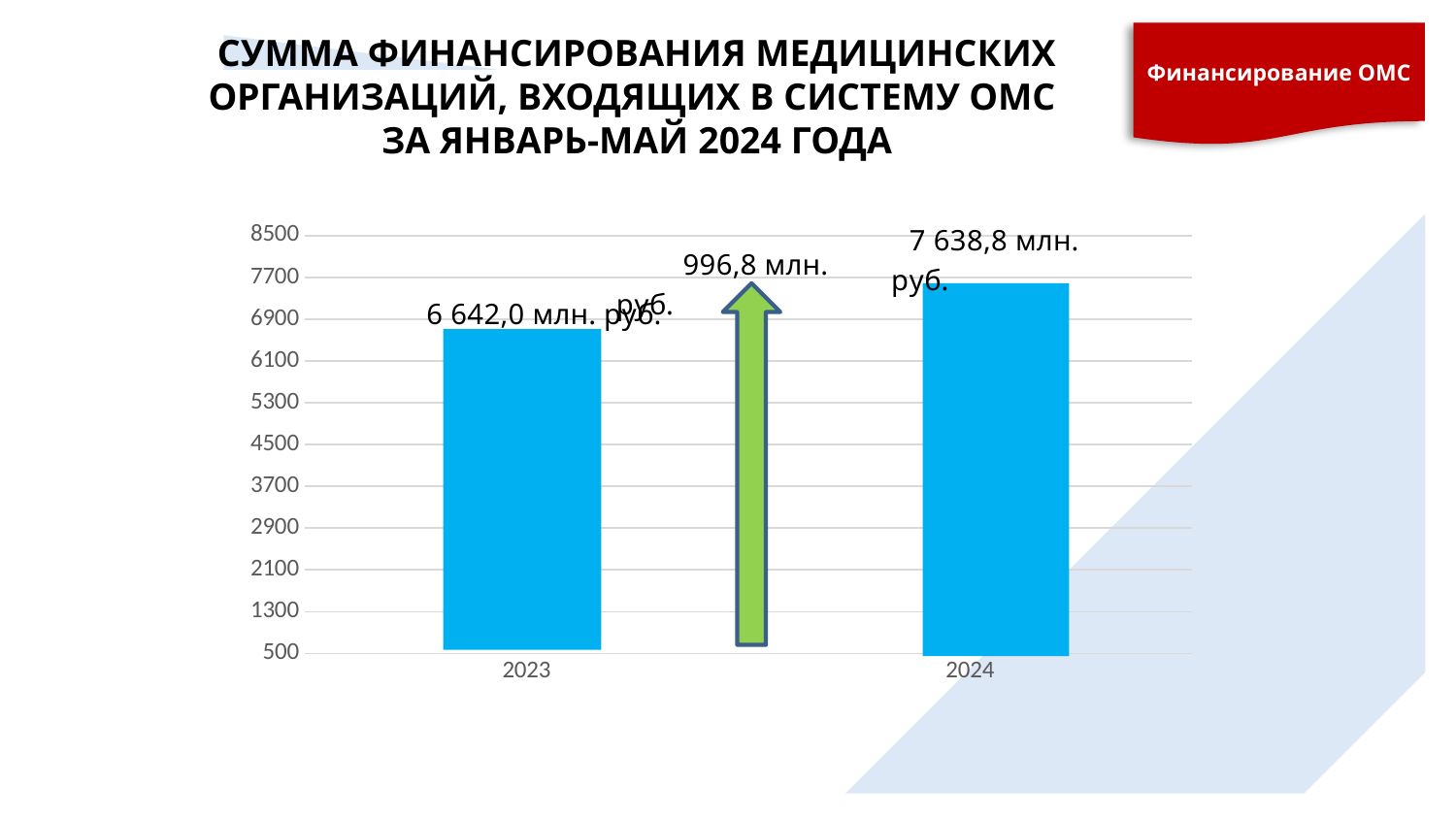
Which year has the higher value? 2024 Is the value for 2024 larger than the value for 2023? Yes How many bars are shown in the chart? 2 Is the value for 2024 greater or less than 7700? less Is the value for 2023 greater or less than 6900? less What kind of chart is shown on the slide? Bar chart What is the lowest value shown on the vertical axis? 500 What is the value for 2023? 6 642,0 млн. руб. Do the values rise or fall from 2023 to 2024? Rise What is the difference between the 2024 and 2023 values? 996,8 млн. руб. Which year has the lower value? 2023 What is the value for 2024? 7 638,8 млн. руб.